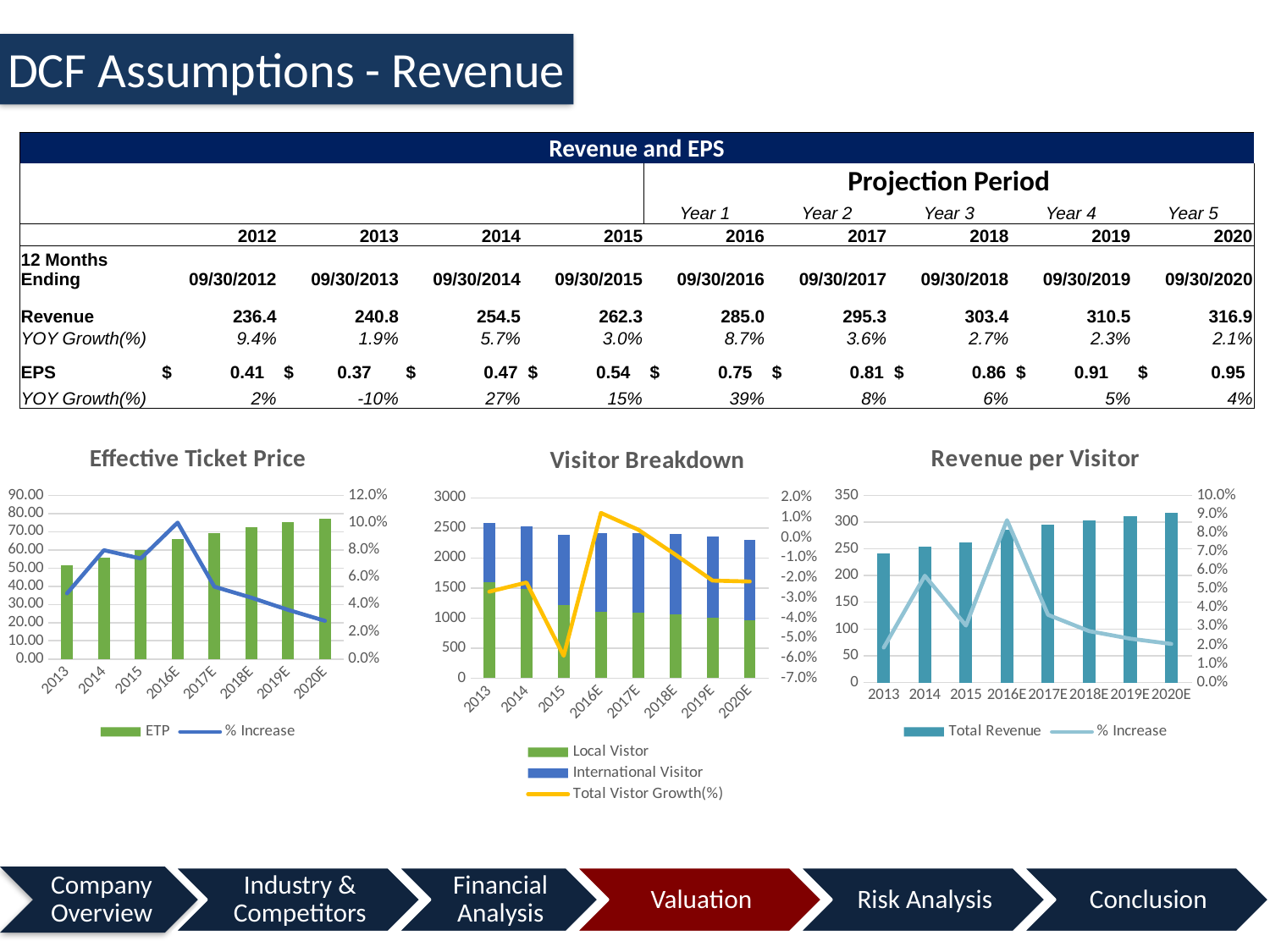
In the Revenue per Visitor chart, which year has the highest % Increase? 2016E In the Effective Ticket Price chart, what kind of chart is used for the ETP series? bar chart In the Effective Ticket Price chart, is the ETP value for 2020E greater or less than 70.00? greater In the Visitor Breakdown chart, which year has the highest Total Vistor Growth(%)? 2016E In the Visitor Breakdown chart, which year has the lowest Total Vistor Growth(%)? 2015 In the Effective Ticket Price chart, which year has the highest % Increase? 2016E In the Revenue per Visitor chart, is the Total Revenue value for 2013 greater or less than 250? less What are the two legend entries of the Revenue per Visitor chart? Total Revenue and % Increase In the Visitor Breakdown chart, is the Local Vistor value larger in 2013 or in 2020E? 2013 How many years are shown on the x axis of the Effective Ticket Price chart? 8 How many series does the legend of the Visitor Breakdown chart list? 3 In the Effective Ticket Price chart, do the ETP bars rise or fall from 2013 to 2020E? rise